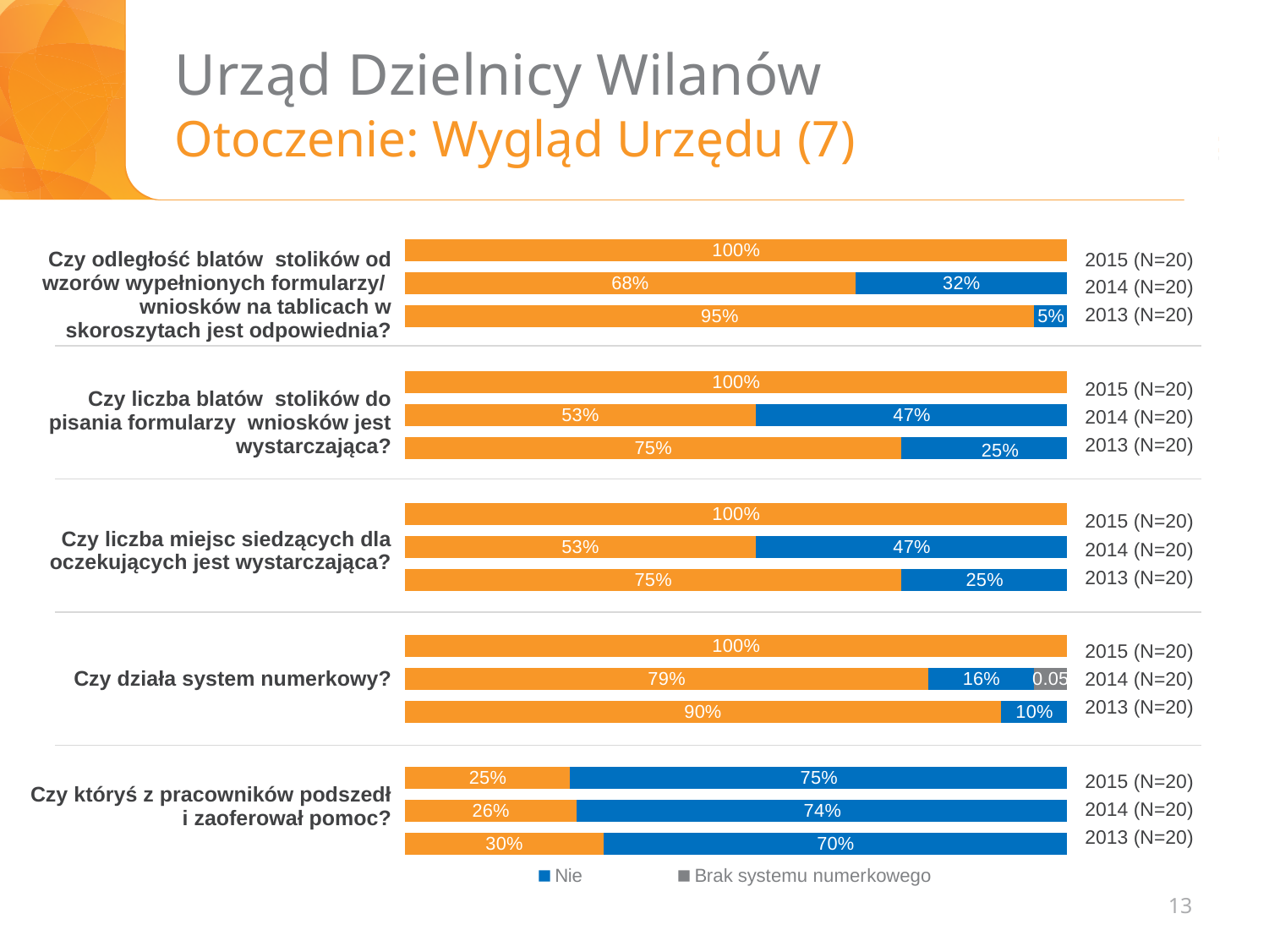
In the chart for "Czy działa system numerkowy?", what is the orange value for 2013 (N=20)? 90% In the chart for "Czy któryś z pracowników podszedł i zaoferował pomoc?", which year has the highest orange value? 2013 In the chart for "Czy któryś z pracowników podszedł i zaoferował pomoc?", does the blue value rise or fall from 2013 to 2015? rise In the chart for "Czy odległość blatów stolików od wzorów wypełnionych formularzy/wniosków na tablicach w skoroszytach jest odpowiednia?", what is the blue value for 2014 (N=20)? 32% What kind of chart is used on this slide? Stacked bar chart What sample size (N) is shown for 2015 in the chart for "Czy liczba miejsc siedzących dla oczekujących jest wystarczająca?"? N=20 How many years (bars) are shown for each question on the slide? 3 In the chart for "Czy któryś z pracowników podszedł i zaoferował pomoc?", what is the blue value for 2015 (N=20)? 75% In the chart for "Czy działa system numerkowy?", which year has the larger orange value, 2014 or 2013? 2013 What are the two legend entries shown at the bottom of the slide? Nie; Brak systemu numerkowego In the chart for "Czy działa system numerkowy?", what is the grey value for 2014 (N=20)? 0.05 In the chart for "Czy liczba blatów stolików do pisania formularzy wniosków jest wystarczająca?", what is the difference between the orange and blue values for 2013 (N=20)? 50 percentage points